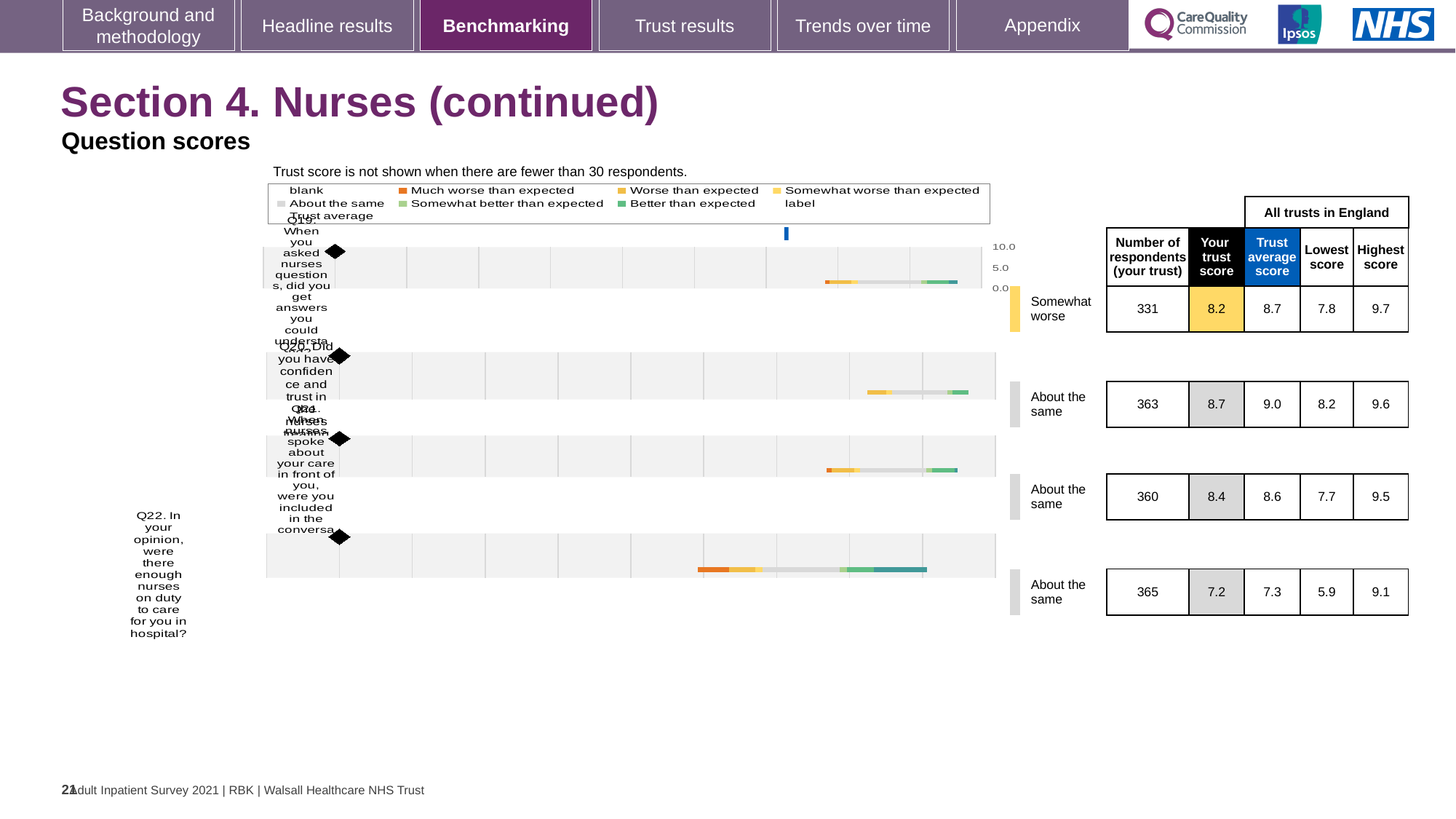
What is the highest score across all trusts in England for Q20? 9.6 How many questions are plotted in the chart? 4 For Q21, which is larger: your trust score or the trust average score? Trust average score What kind of chart is used to show the question scores? Bar chart How many respondents (your trust) are shown for Q22? 365 What is the difference between the trust average score and your trust score for Q19? 0.5 What is the lowest score across all trusts in England for Q22? 5.9 Which question has the highest 'Your trust score'? Q20 Which question has the lowest 'Your trust score'? Q22 What is the 'Your trust score' value for Q19? 8.2 What benchmark category is shown for Q19? Somewhat worse What is the trust average score for Q22? 7.3